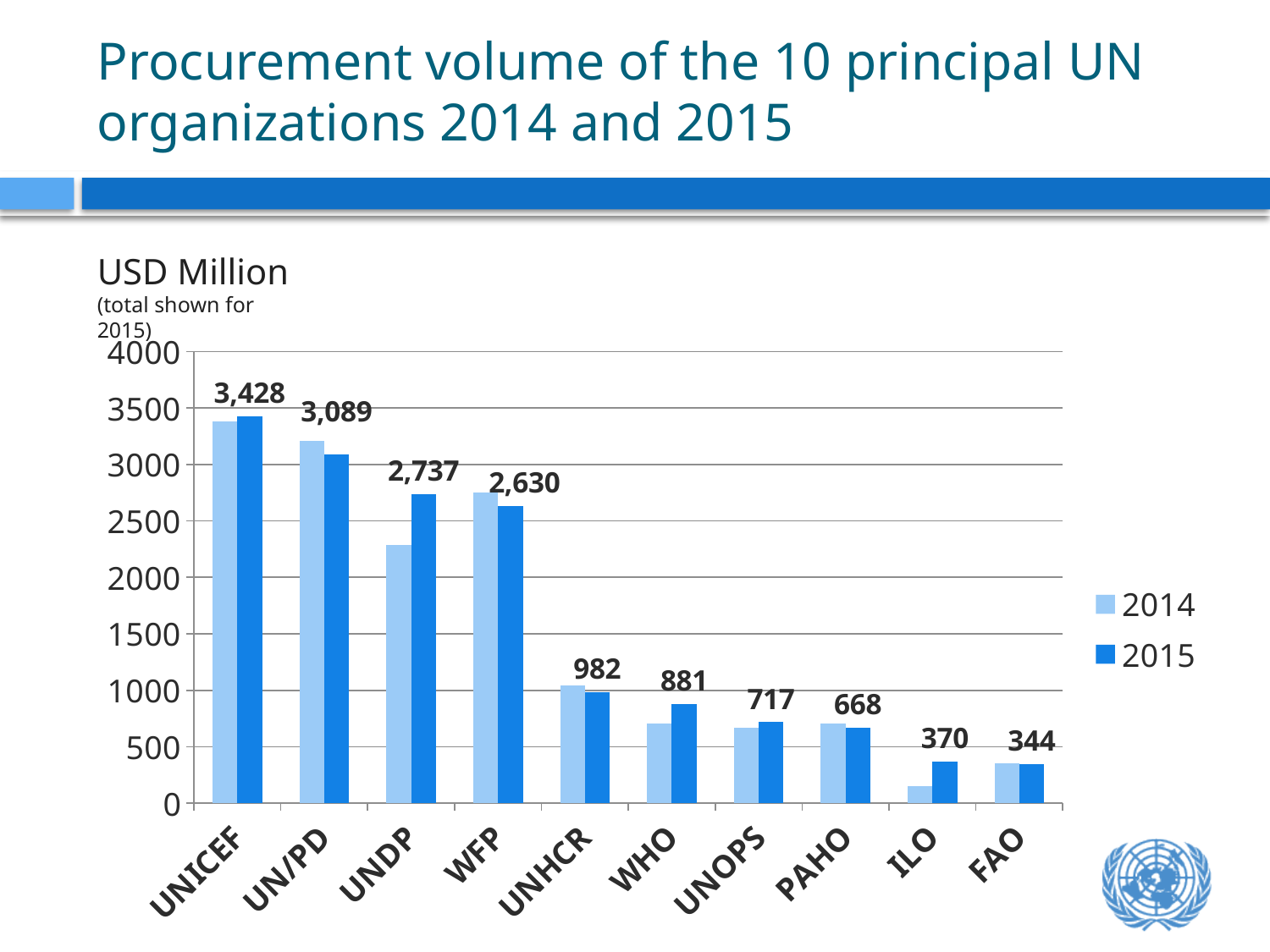
What is the 2015 procurement volume for FAO? 344 What is the 2015 procurement volume for UNHCR? 982 What is the difference between the 2015 procurement volumes of ILO and FAO? 26 Is the 2014 value for ILO greater or less than 500? less For WFP, which year has the larger procurement volume, 2014 or 2015? 2014 Which organization has the lowest 2015 procurement volume? FAO What is the difference between the 2015 procurement volumes of UNICEF and UN/PD? 339 How many organizations are shown on the x axis? 10 How many series does the legend list? 2 What is the 2015 procurement volume for UNICEF? 3,428 For UNDP, which year has the larger procurement volume, 2014 or 2015? 2015 Which organization has the highest 2015 procurement volume? UNICEF